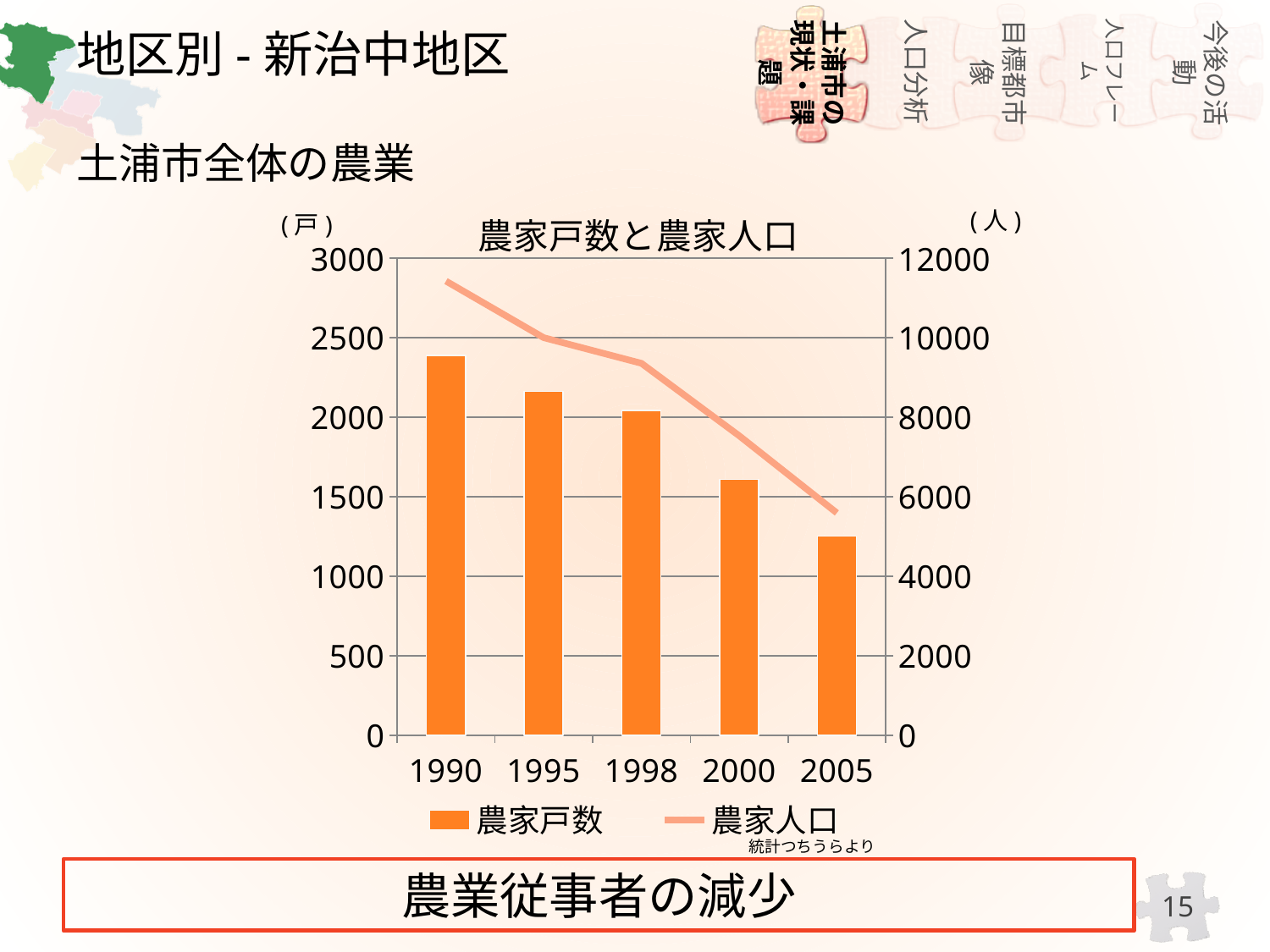
Do the values for 農家人口 rise or fall from 1990 to 2005? fall How many series does the legend list? 2 What kind of chart is shown on the slide? Combined bar and line chart What is the title of the chart? 農家戸数と農家人口 How many years are shown on the x axis? 5 Is the value for 農家戸数 in 1990 greater or less than 2000? greater Which year has the highest value for 農家戸数? 1990 Is the value for 農家戸数 in 2005 greater or less than 1500? less Which year has the lowest value for 農家戸数? 2005 Is the value for 農家人口 in 2005 greater or less than 6000? less Which year has the lowest value for 農家人口? 2005